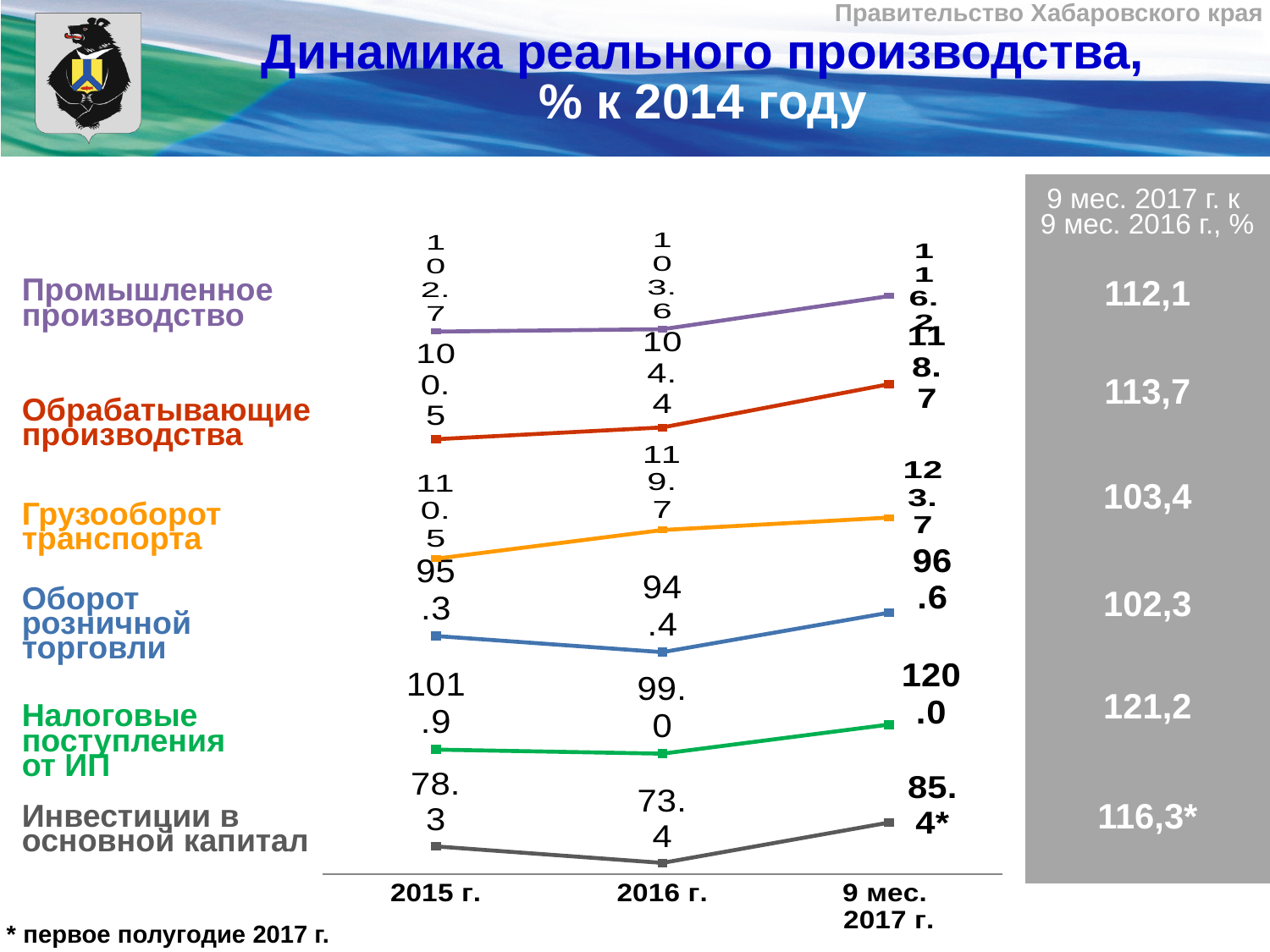
What is the value for Грузооборот транспорта for 9 мес. 2017 г.? 123.7 What type of chart is shown on the slide? line chart What is the value for Инвестиции в основной капитал in 2015 г.? 78.3 What is the value for Промышленное производство in 2016 г.? 103.6 How many time points are plotted along the x axis? 3 Which series has the lowest value in 2016 г.? Инвестиции в основной капитал Does the Оборот розничной торговли line rise or fall from 2015 г. to 2016 г.? fall Which series has the highest value for 9 мес. 2017 г.? Грузооборот транспорта Which is larger in 2015 г.: Обрабатывающие производства or Оборот розничной торговли? Обрабатывающие производства How many series (lines) does the chart show? 6 What is the title of the chart on the slide? Динамика реального производства, % к 2014 году By how much did Налоговые поступления от ИП change from 2016 г. to 9 мес. 2017 г.? 21.0